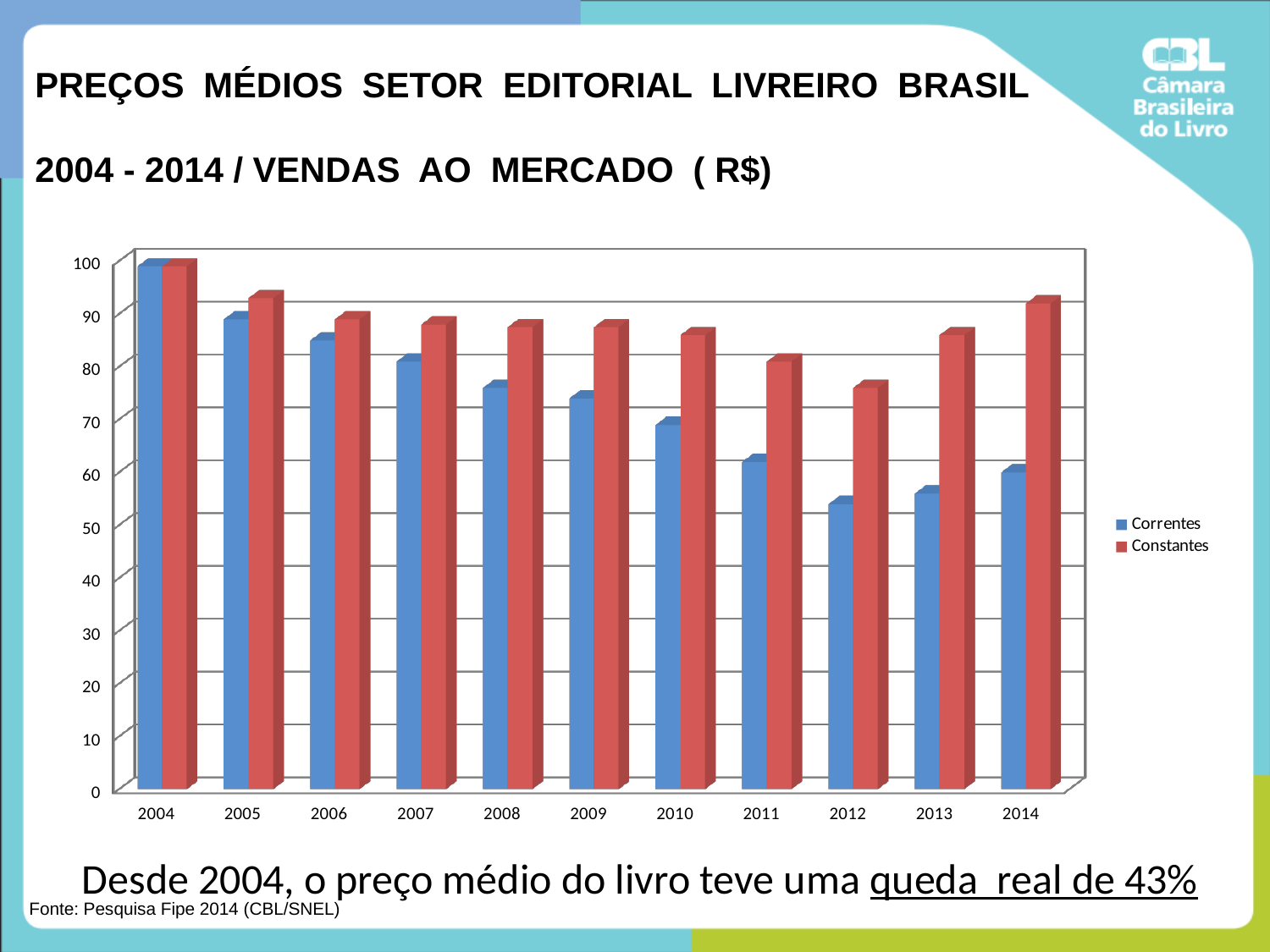
Is the Correntes value for 2008 greater or less than 70? greater Is the Correntes value for 2012 greater or less than 60? less Which year has the highest value for the Constantes series? 2004 Is the Constantes value for 2012 greater or less than 70? greater Which is larger, the Correntes value for 2005 or the Correntes value for 2009? 2005 Which year has the lowest value for the Constantes series? 2012 Which is larger, the Constantes value for 2014 or the Constantes value for 2013? 2014 What kind of chart is shown on the slide? bar chart Do the Correntes values generally rise or fall from 2004 to 2012? fall How many series does the legend list? 2 How many years are shown on the x axis? 11